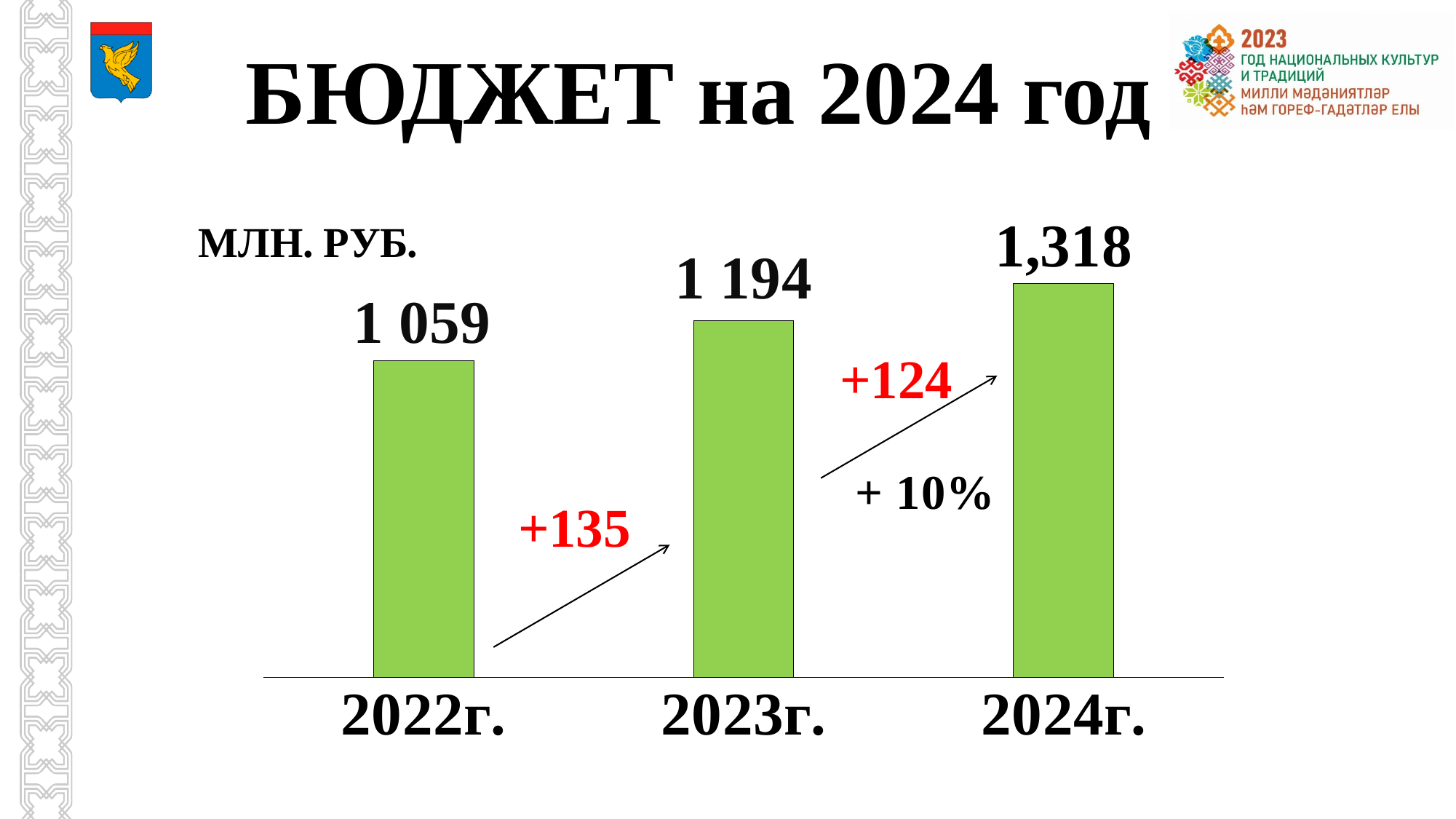
By how much does the budget increase from 2022г. to 2023г.? 135 Which year has the lowest budget value? 2022г. How many years (bars) are shown in the chart? 3 What is the budget value shown for 2022г.? 1 059 Which is larger, the budget for 2023г. or for 2024г.? 2024г. In what units are the budget values given on the chart? млн. руб. What kind of chart is shown on the slide? Bar chart What is the budget value shown for 2023г.? 1 194 What is the budget value shown for 2024г.? 1,318 Which year has the highest budget value? 2024г. Do the budget values rise or fall from 2022г. to 2024г.? Rise By how much does the budget increase from 2023г. to 2024г.? 124